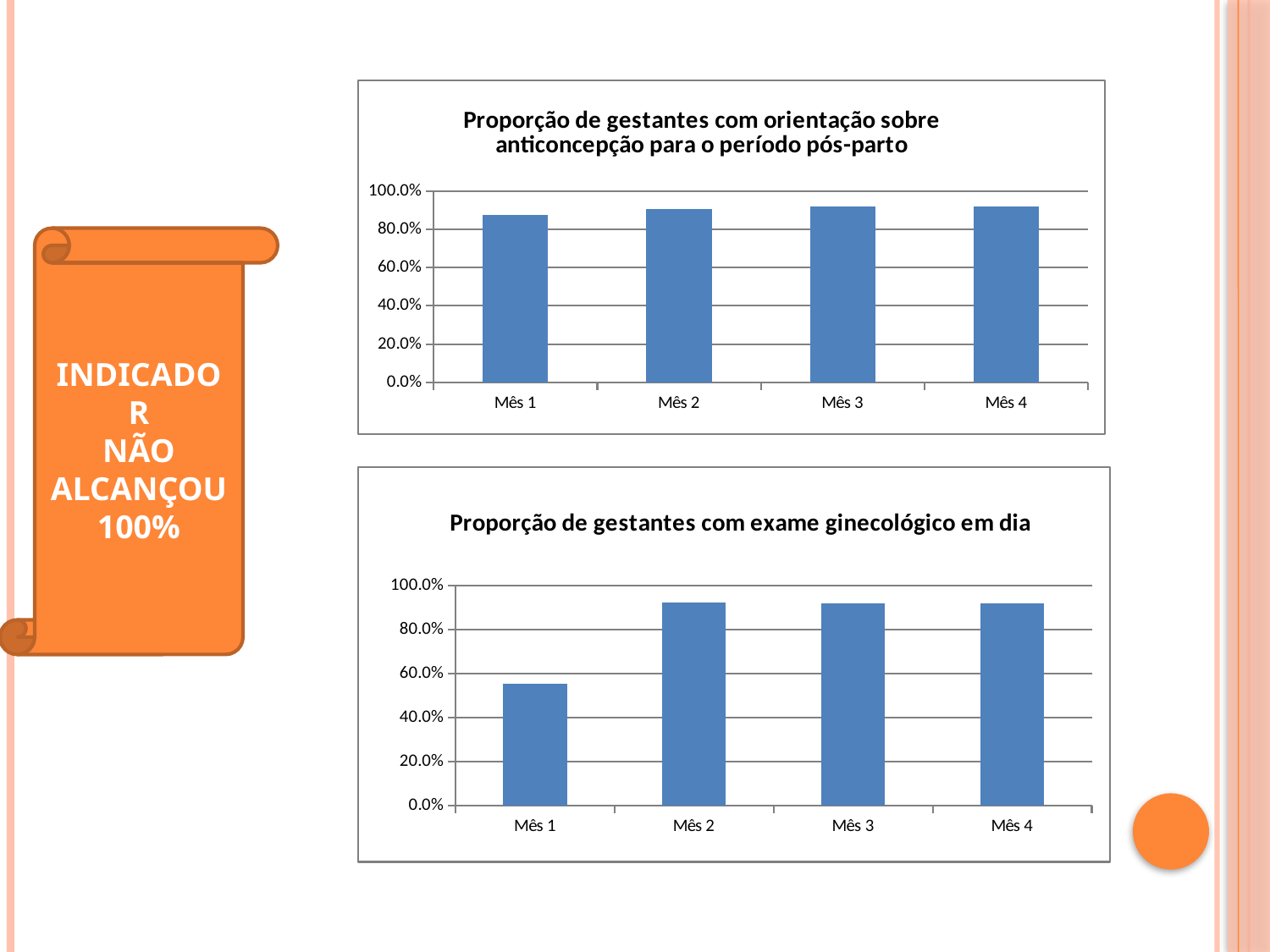
In the top chart, 'Proporção de gestantes com orientação sobre anticoncepção para o período pós-parto', is the value for Mês 1 greater or less than 80.0%? greater What is the label of the first category on the x axis of the top chart? Mês 1 In the bottom chart, 'Proporção de gestantes com exame ginecológico em dia', is the value for Mês 1 greater or less than 60.0%? less In the top chart, 'Proporção de gestantes com orientação sobre anticoncepção para o período pós-parto', which is larger, the value for Mês 1 or the value for Mês 3? Mês 3 What kind of chart is the top chart, 'Proporção de gestantes com orientação sobre anticoncepção para o período pós-parto'? bar chart In the bottom chart, 'Proporção de gestantes com exame ginecológico em dia', which is larger, the value for Mês 1 or the value for Mês 2? Mês 2 In the bottom chart, 'Proporção de gestantes com exame ginecológico em dia', is the value for Mês 1 greater or less than 40.0%? greater What is the title of the bottom chart on the slide? Proporção de gestantes com exame ginecológico em dia In the bottom chart, 'Proporção de gestantes com exame ginecológico em dia', which month has the lowest value? Mês 1 How many categories are shown on the x axis of the bottom chart, 'Proporção de gestantes com exame ginecológico em dia'? 4